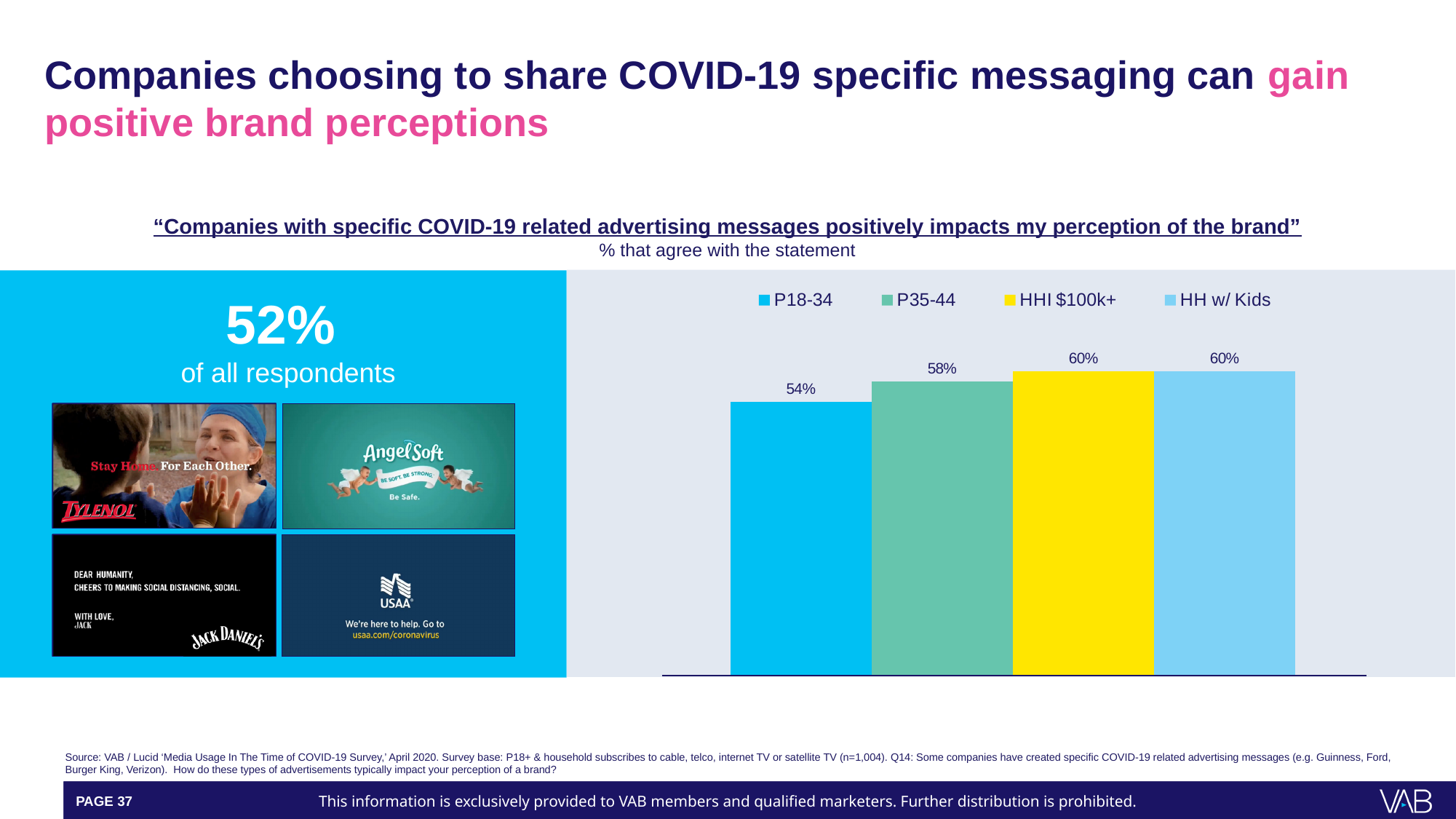
What is the value shown for the P35-44 bar? 58% What percentage of all respondents agree with the statement, as shown in the blue panel on the left? 52% What is the difference in percentage points between the P35-44 and P18-34 bars? 4 percentage points What is the difference in percentage points between the HHI $100k+ bar and the P18-34 bar? 6 percentage points What percentage of P18-34 respondents agree that companies with specific COVID-19 related advertising messages positively impact their perception of the brand? 54% How many series does the legend list? 4 What percentage is shown for the HHI $100k+ group? 60% How many bars are plotted in the chart? 4 Which group has the lowest percentage agreeing with the statement? P18-34 What kind of chart is shown on the slide? Bar chart What value is labelled on the HH w/ Kids bar? 60% Which is larger, the value for P35-44 or the value for P18-34? P35-44